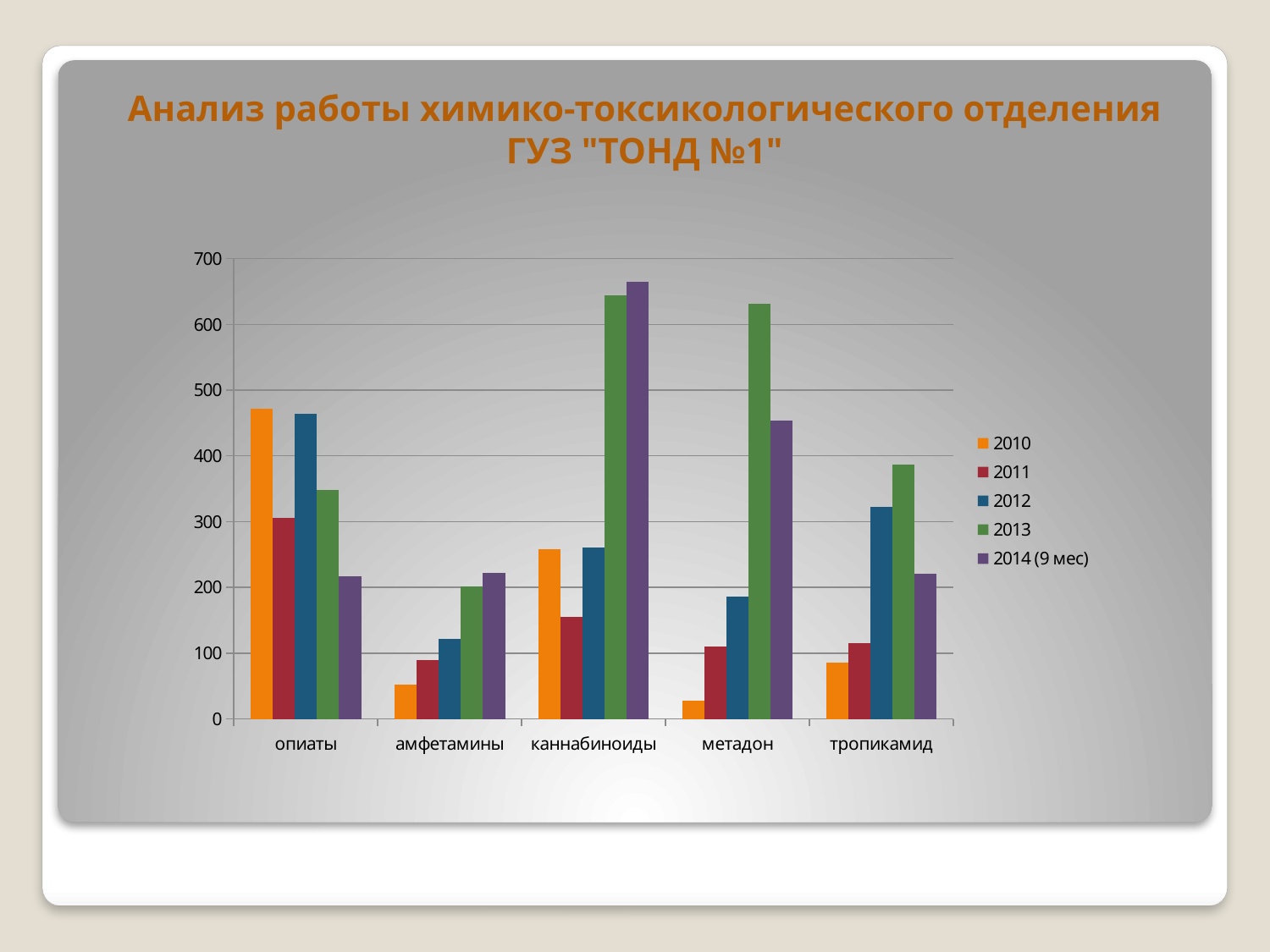
Which category has the lowest value for the 2010 series? метадон For амфетамины, do the values rise or fall from 2010 to 2014 (9 мес)? rise Is the 2013 value for метадон greater or less than 600? greater For опиаты, which series has the larger value: 2010 or 2014 (9 мес)? 2010 Is the 2012 value for тропикамид greater or less than 300? greater For тропикамид, which series has the larger value: 2012 or 2013? 2013 Which category has the highest value for the 2014 (9 мес) series? каннабиноиды How many categories are shown on the x axis of the chart? 5 What kind of chart is shown on the slide? bar chart What colour represents the 2013 series in the legend? green How many series does the legend list? 5 Is the 2010 value for опиаты greater or less than 400? greater